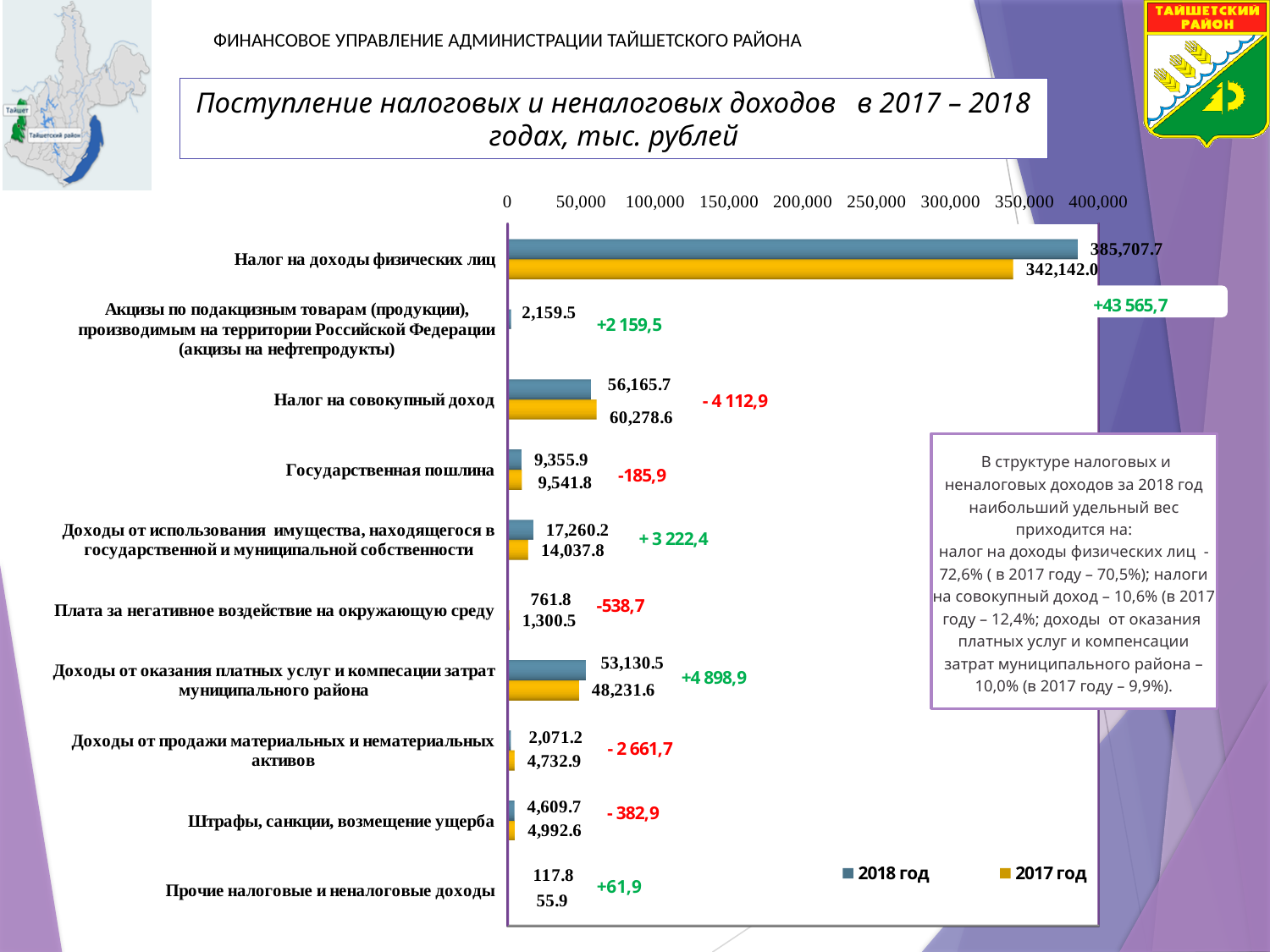
What is the difference between the 2018 год and 2017 год values for Налог на доходы физических лиц? 43,565.7 What is the 2017 год value for Налог на совокупный доход? 60,278.6 How many series does the chart legend list? 2 Which category has the highest 2018 год value? Налог на доходы физических лиц Which colour represents the 2017 год series in the chart? Yellow What is the 2018 год value for Доходы от оказания платных услуг и компесации затрат муниципального района? 53,130.5 For Государственная пошлина, which year has the larger value, 2018 год or 2017 год? 2017 год Is the 2017 год value for Налог на доходы физических лиц greater or less than 300,000? greater What type of chart is shown on the slide? Bar chart Which category has the lowest 2017 год value among those with a printed 2017 value? Прочие налоговые и неналоговые доходы What is the 2018 год value for Налог на доходы физических лиц? 385,707.7 How many categories are plotted on the chart? 10